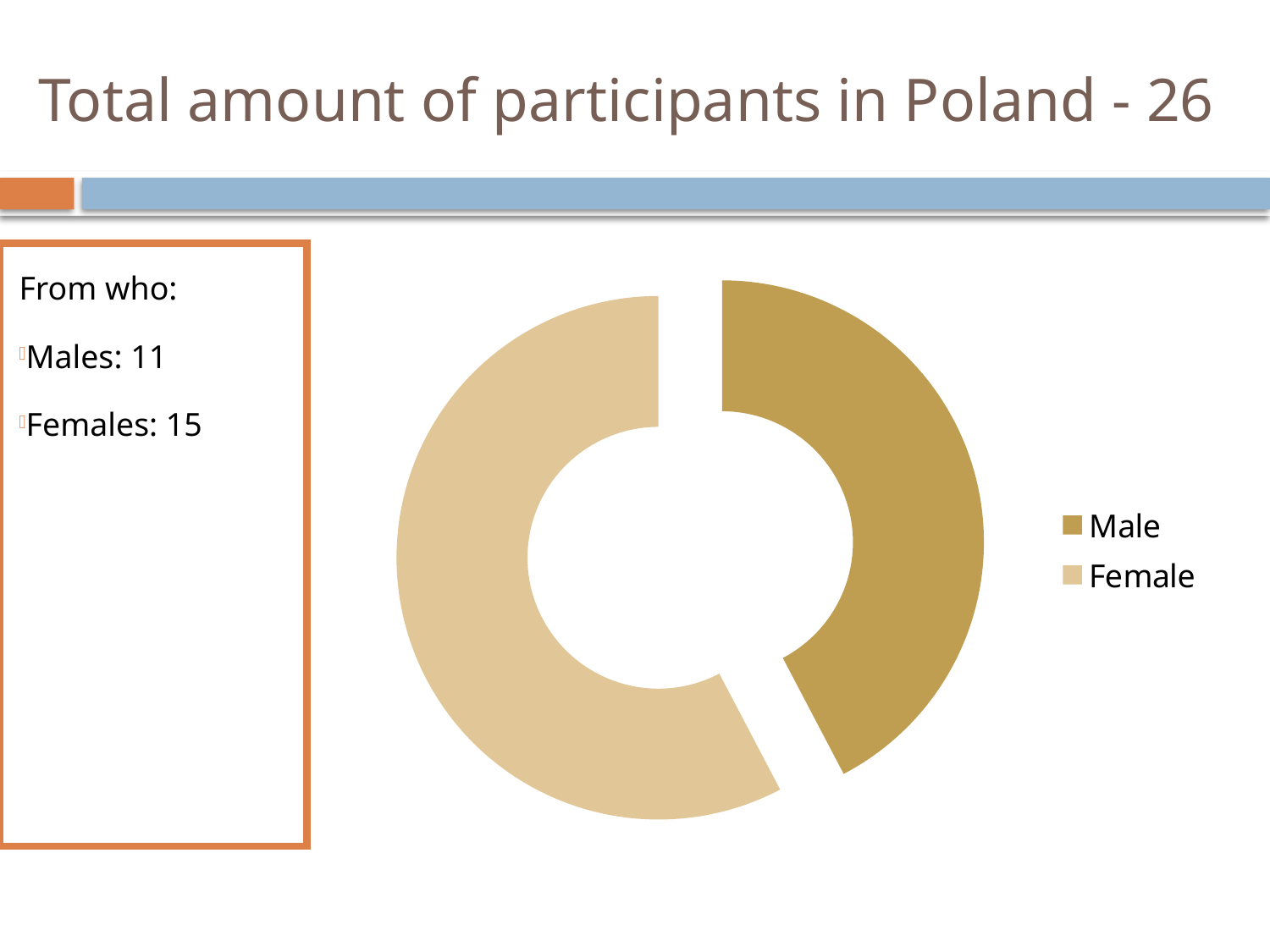
Which category has the smallest slice in the chart? Male Which category has the largest slice in the chart? Female How many female participants does the slide report? 15 What kind of chart is shown on the slide? doughnut chart What is the total number of participants represented in the chart? 26 What are the two legend entries of the chart? Male, Female What is the title of the slide containing the chart? Total amount of participants in Poland - 26 What is the difference between the number of female and male participants? 4 How many entries does the chart legend list? 2 How many categories does the chart show? 2 Which category has the larger slice in the chart, Male or Female? Female How many male participants does the slide report? 11